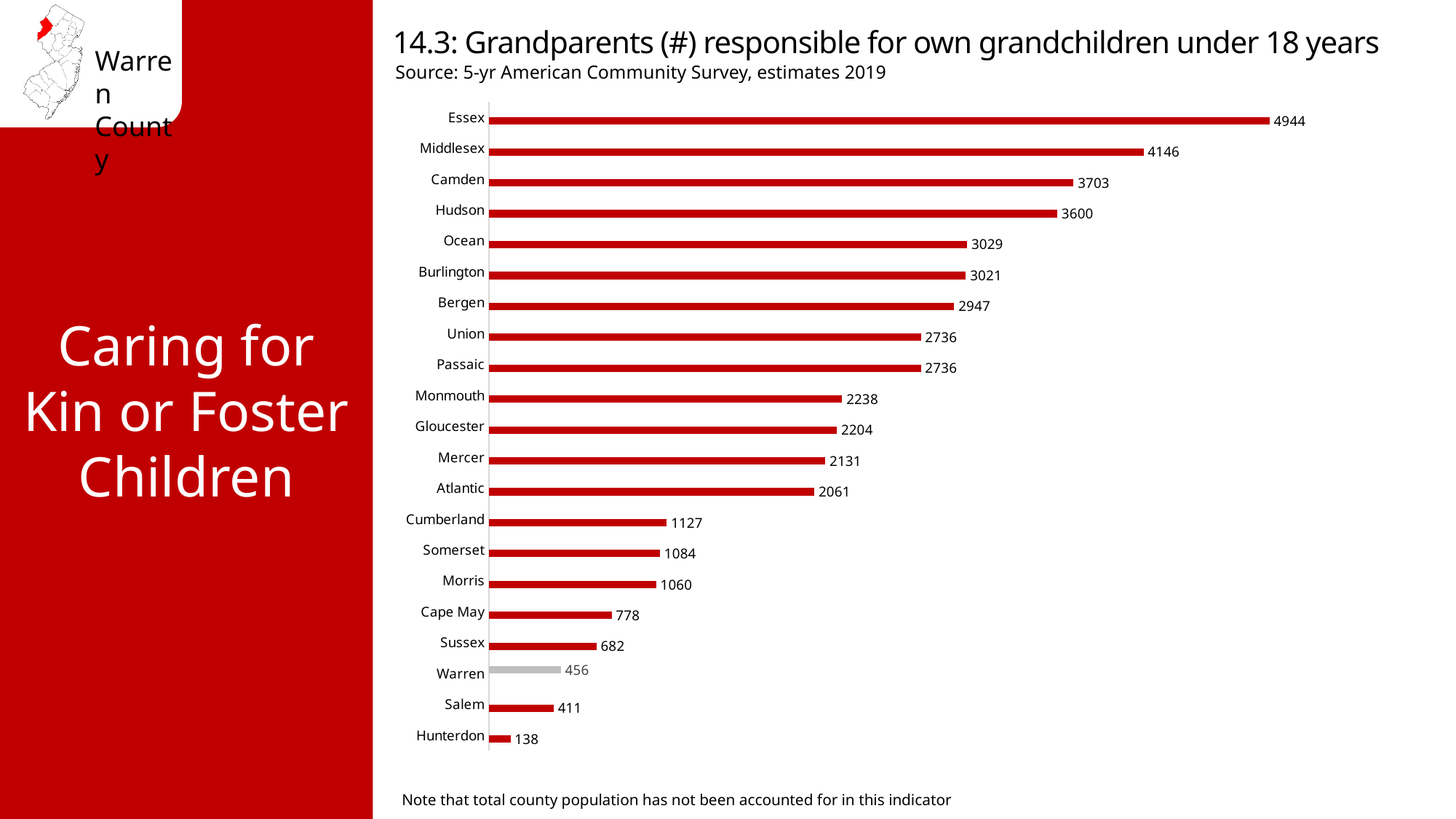
What is the value for Cape May? 778 What is the difference between the values for Essex and Hunterdon? 4806 What is the difference between the values for Warren and Salem? 45 What kind of chart is shown on the slide? Bar chart Which has a larger value, Sussex or Warren? Sussex What is the value for Warren? 456 What is the value for Essex? 4944 Which county's bar is shown in grey rather than red? Warren Which has a larger value, Camden or Hudson? Camden Which county has the lowest value? Hunterdon Which county has the highest value? Essex How many counties are shown in the chart? 21